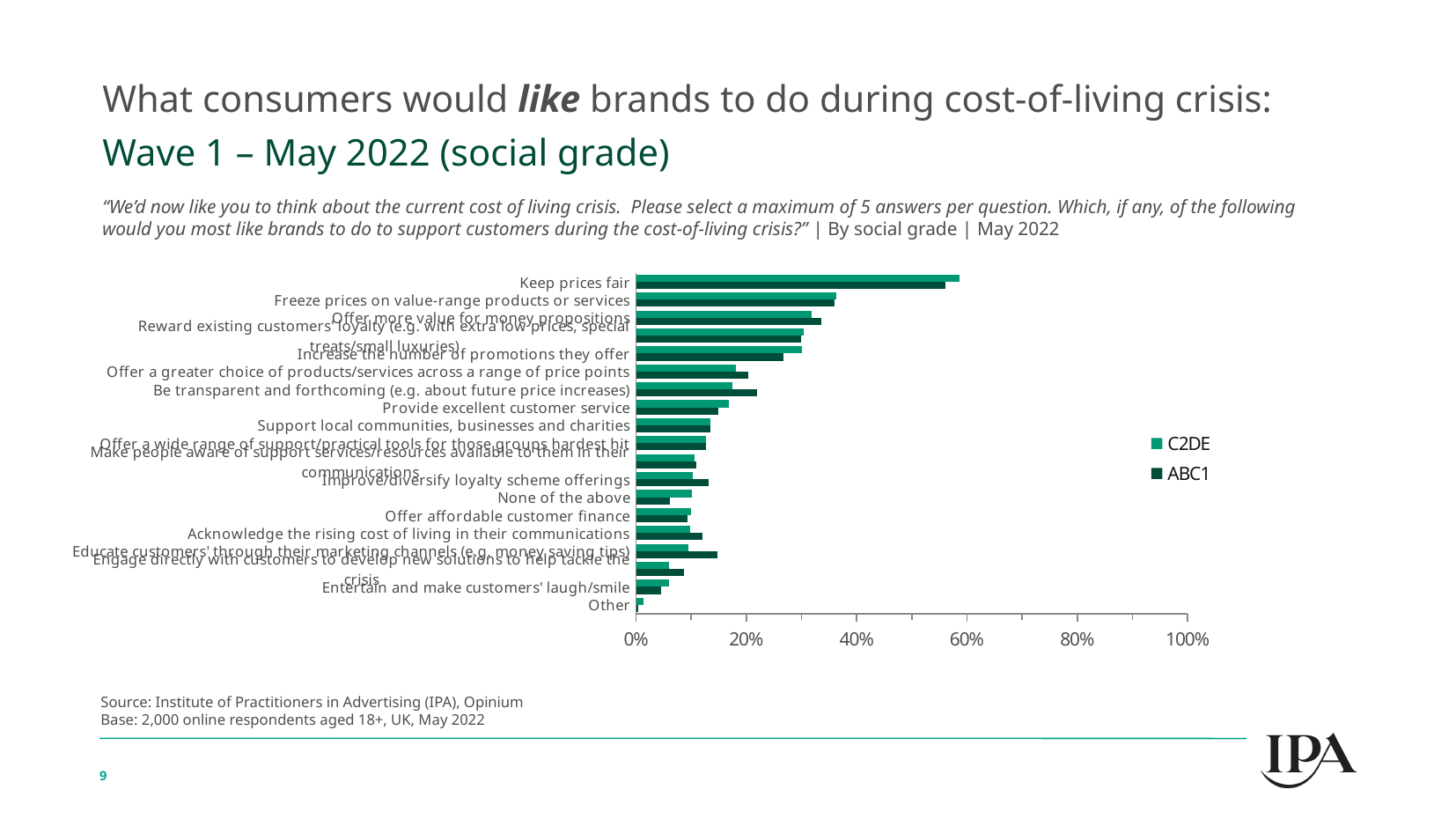
How many series does the legend list? 2 Is the C2DE value for 'Other' greater or less than 20%? less Which has the larger C2DE value: 'Keep prices fair' or 'Freeze prices on value-range products or services'? Keep prices fair Which category has the highest value for the C2DE series? Keep prices fair Is the C2DE value for 'Keep prices fair' greater or less than 40%? greater Is the ABC1 value for 'Keep prices fair' greater or less than 60%? less What kind of chart is shown on the slide? Bar chart Which two series are listed in the legend? C2DE and ABC1 For 'Be transparent and forthcoming (e.g. about future price increases)', which series has the larger value, C2DE or ABC1? ABC1 Which category has the lowest value for the ABC1 series? Other For 'Educate customers' through their marketing channels (e.g. money saving tips)', which series has the larger value, C2DE or ABC1? ABC1